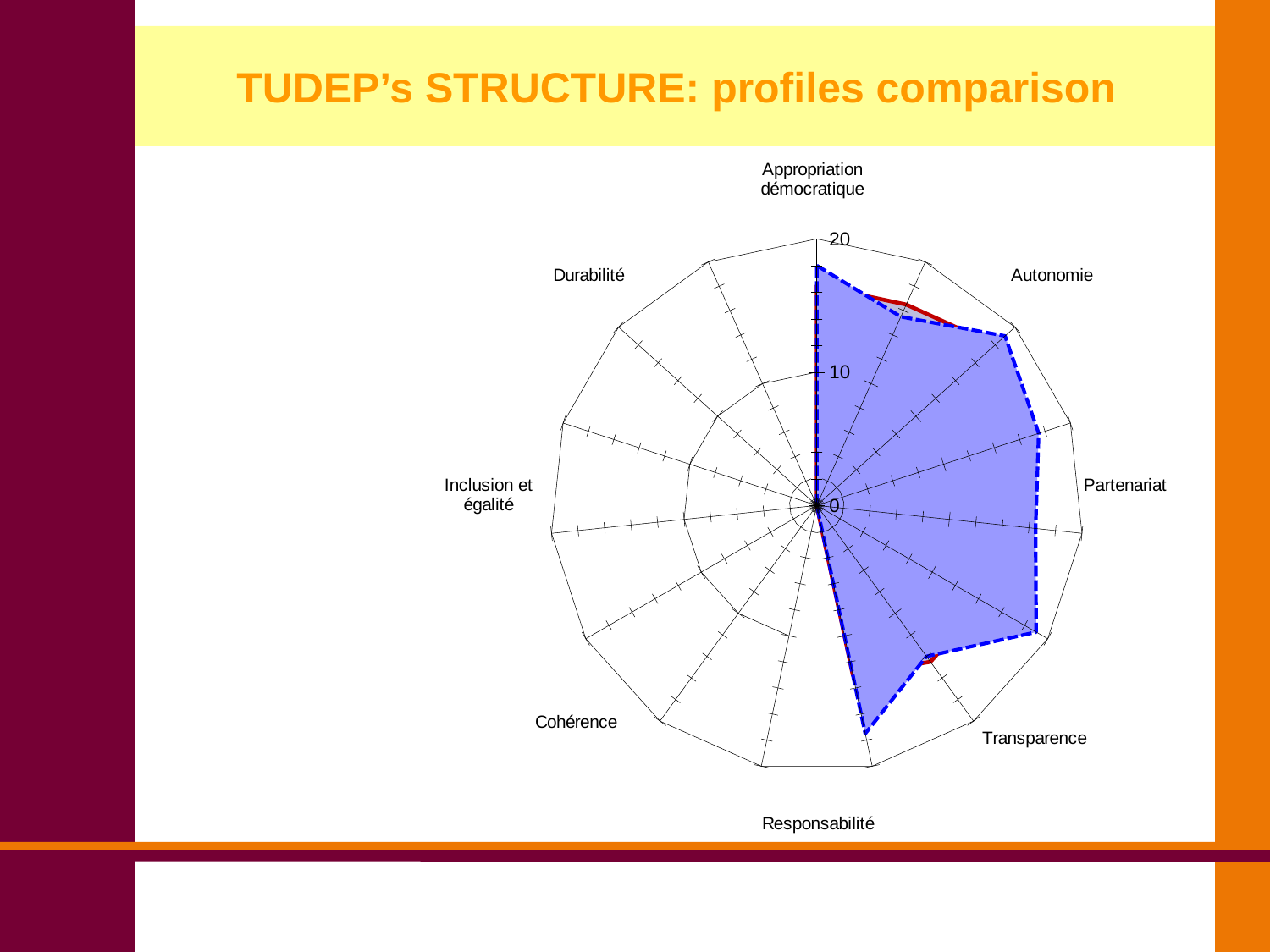
Which is larger, the value for Partenariat or the value for Cohérence? Partenariat What kind of chart is shown on the slide? radar chart Is the value for Autonomie greater or less than 10? greater What is the title of the slide containing the chart? TUDEP's STRUCTURE: profiles comparison Is the value for Cohérence greater or less than 10? less Is the value for Responsabilité greater or less than 10? less What is the highest value marked on the radar chart's axis scale? 20